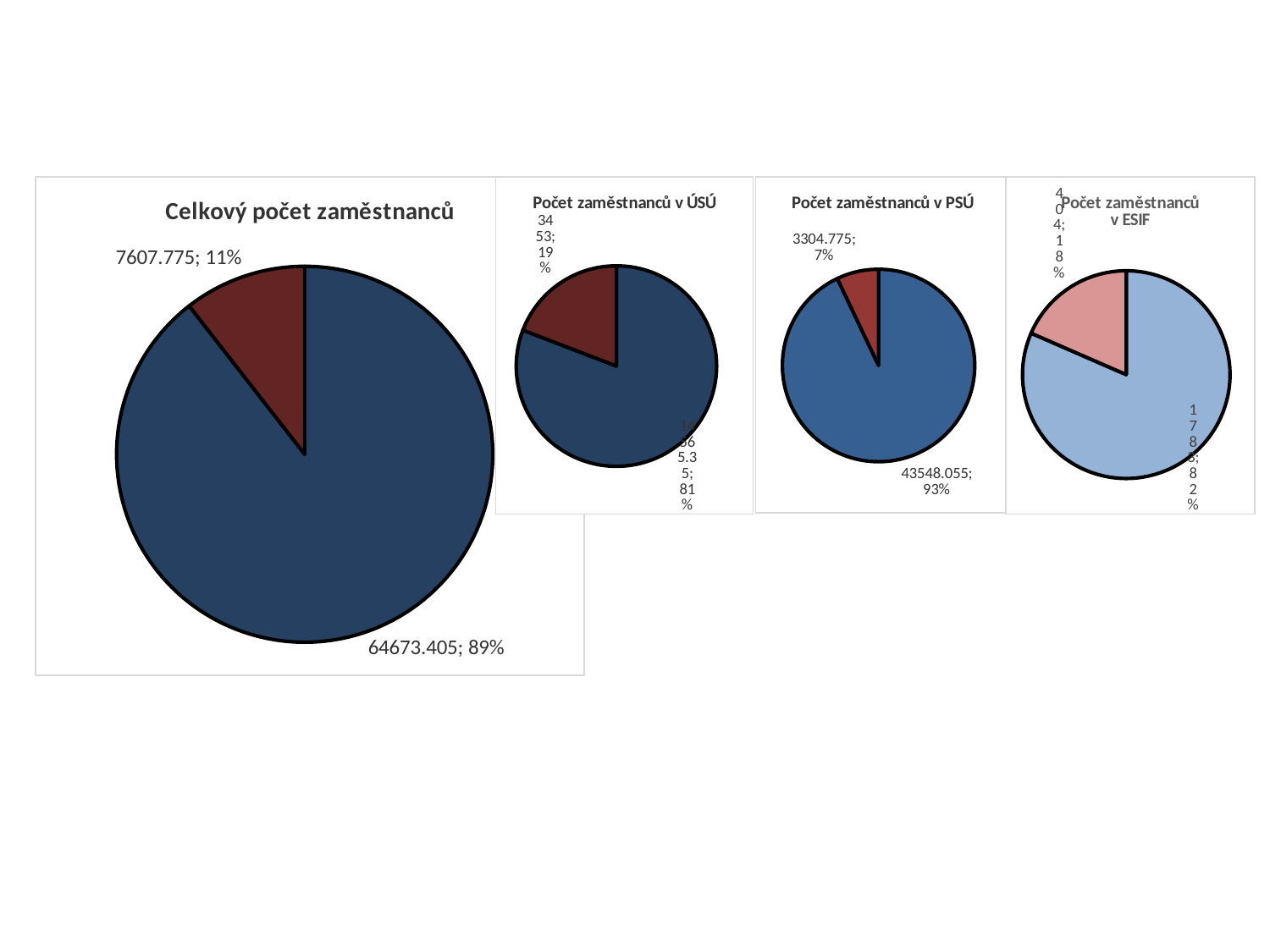
In the "Celkový počet zaměstnanců" chart, what share of the pie does the red slice represent? 11% How many slices does the "Počet zaměstnanců v PSÚ" pie chart have? 2 In the "Počet zaměstnanců v ESIF" chart, what share of the pie does the pink slice represent? 18% In the "Počet zaměstnanců v PSÚ" chart, what share of the pie does the blue slice represent? 93% In the "Celkový počet zaměstnanců" chart, what is the difference between the two slice values? 57065.63 What kind of chart is "Celkový počet zaměstnanců"? Pie chart In the "Počet zaměstnanců v PSÚ" chart, what value is labelled on the red slice? 3304.775 In the "Celkový počet zaměstnanců" chart, what value is labelled on the smaller (red) slice? 7607.775 In the "Počet zaměstnanců v PSÚ" chart, what is the total of the two slice values? 46852.83 How many pie charts are shown on the slide? 4 In the "Celkový počet zaměstnanců" chart, what value is labelled on the larger (blue) slice? 64673.405